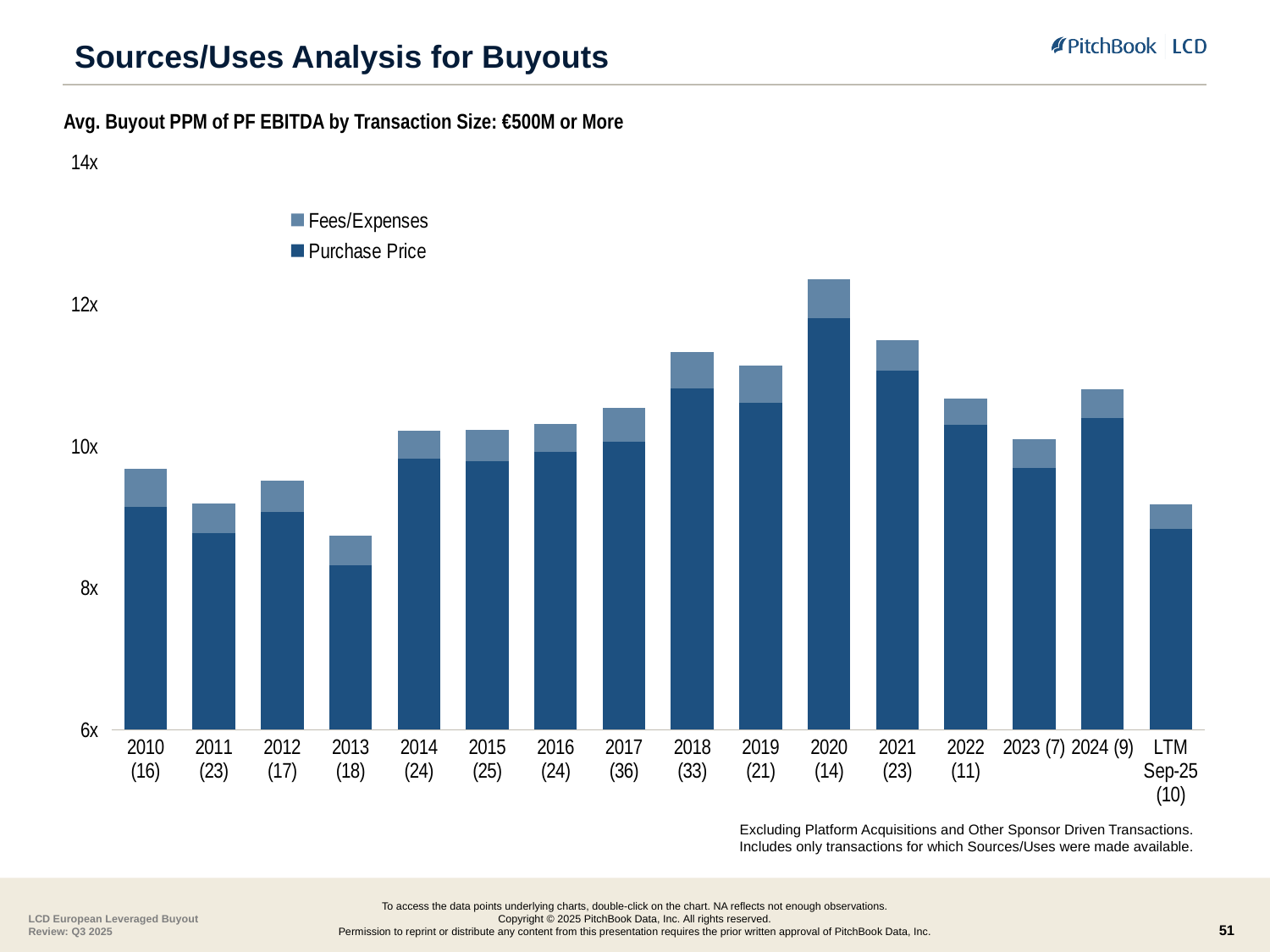
Do the total bar values rise or fall from 2013 to 2020? rise How many series does the legend list? 2 What are the two series named in the legend? Fees/Expenses and Purchase Price Which period has the highest total bar? 2020 Is the total value for 2013 greater or less than 10x? less Which period has the lowest total bar? 2013 What kind of chart is shown on the slide? bar chart Which has the larger total bar, 2020 or 2021? 2020 Is the total value for 2020 greater or less than 12x? greater Is the total value for LTM Sep-25 greater or less than 10x? less How many bars (periods) are shown on the x axis? 16